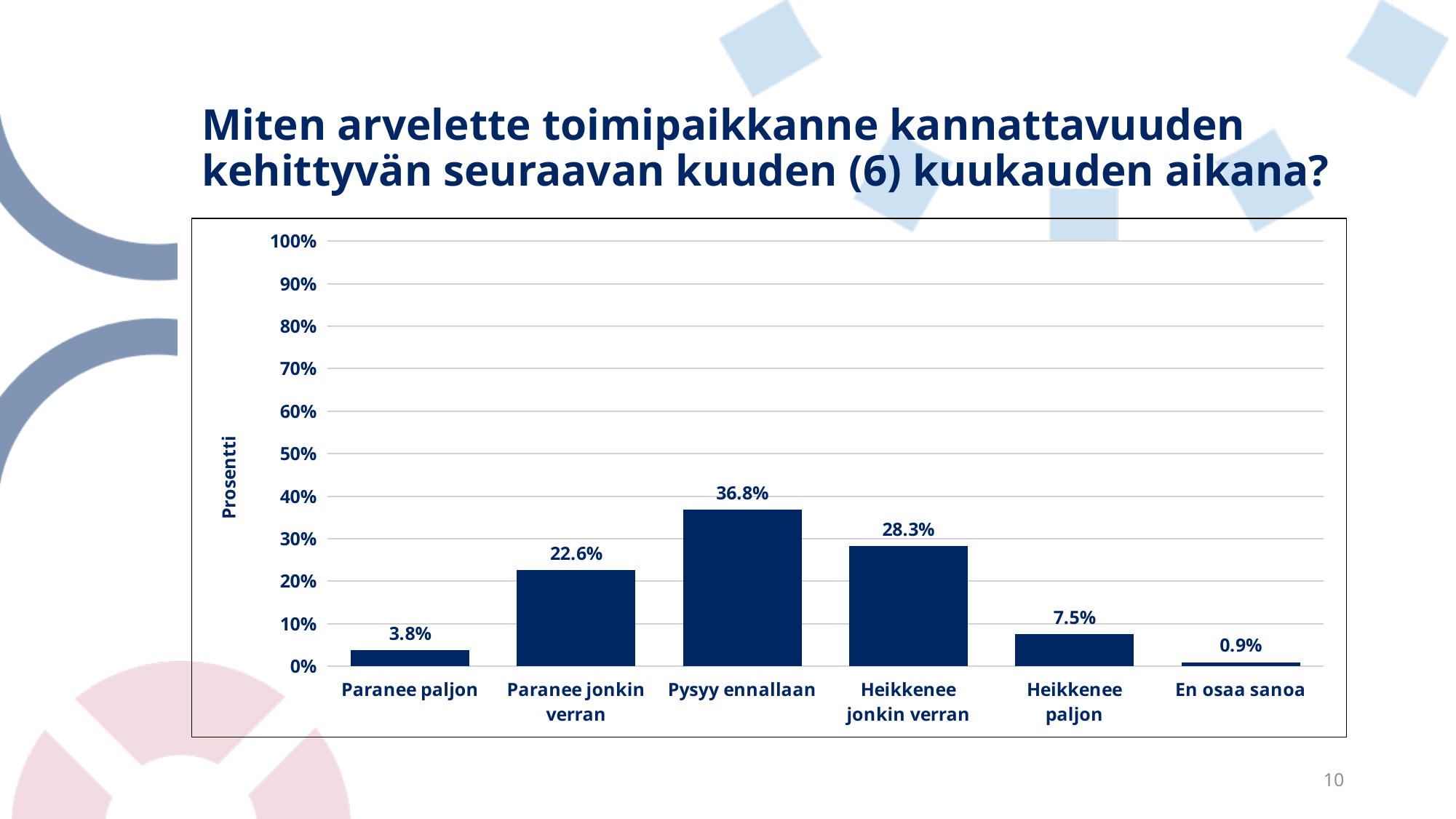
Which is larger, "Paranee paljon" or "Heikkenee paljon"? Heikkenee paljon What is the difference between "Pysyy ennallaan" and "Heikkenee jonkin verran"? 8.5% What is the value for "Heikkenee paljon"? 7.5% Which category has the lowest value? En osaa sanoa What is the value for "Paranee jonkin verran"? 22.6% What is the value for "Pysyy ennallaan"? 36.8% What is the value for "En osaa sanoa"? 0.9% What kind of chart is shown on the slide? bar chart What is the label of the vertical axis? Prosentti Which category has the highest value? Pysyy ennallaan How many categories are shown on the x axis? 6 Is the value for "Heikkenee jonkin verran" greater or less than 30%? less